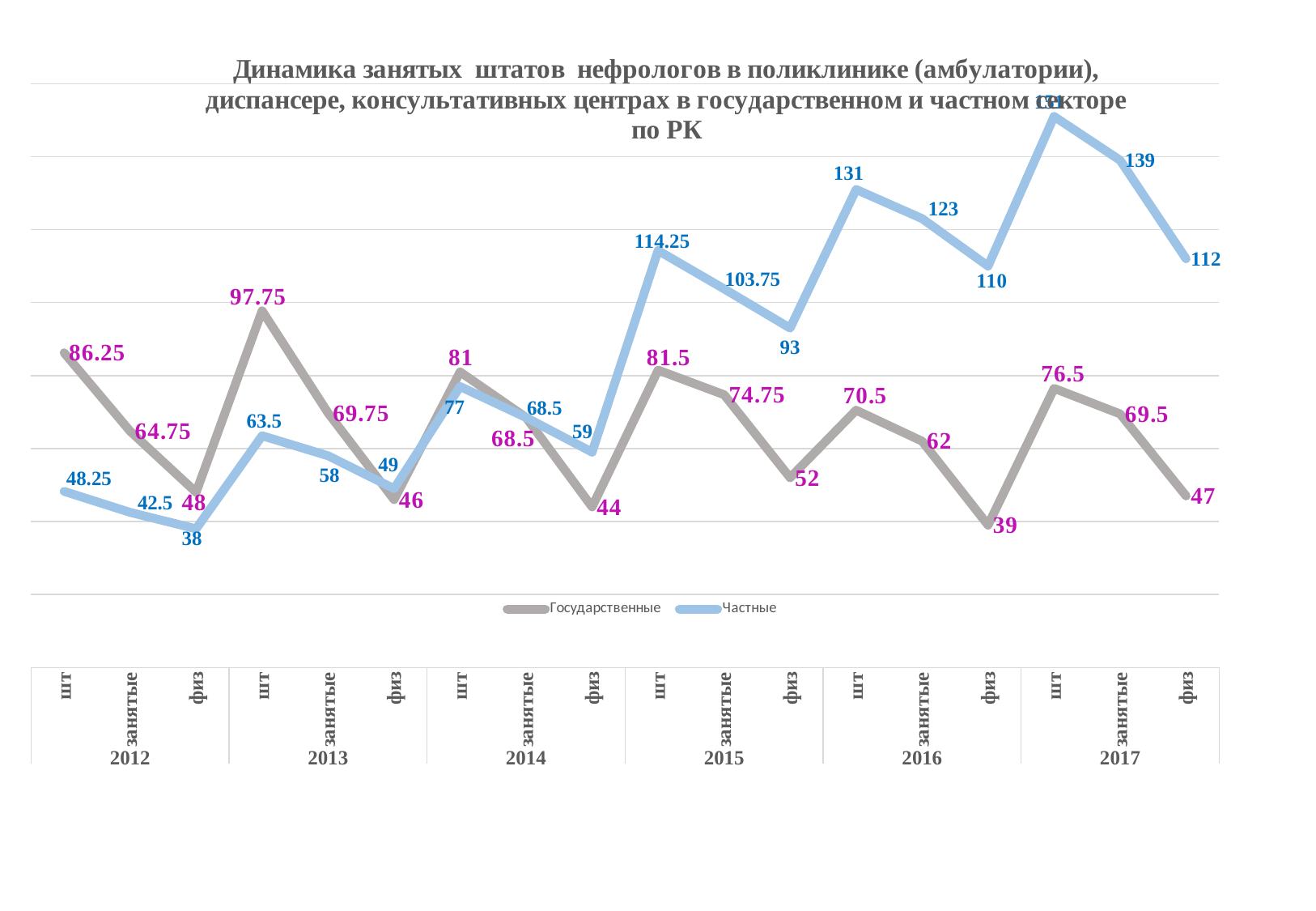
How many years are shown on the x axis? 6 At which category does the Государственные series have its lowest value? физ 2016 How many series does the legend list? 2 At which category does the Частные series have its lowest value? физ 2012 What is the value for Частные at занятые in 2017? 139 At which category does the Государственные series reach its highest value? шт 2013 What type of chart is shown on the slide? line chart What is the value for Государственные at физ in 2016? 39 What is the value for Государственные at шт in 2013? 97.75 Which series has the larger value at физ in 2015, Государственные or Частные? Частные What is the value for Частные at физ in 2012? 38 What is the difference between the Частные and Государственные values at шт in 2016? 60.5